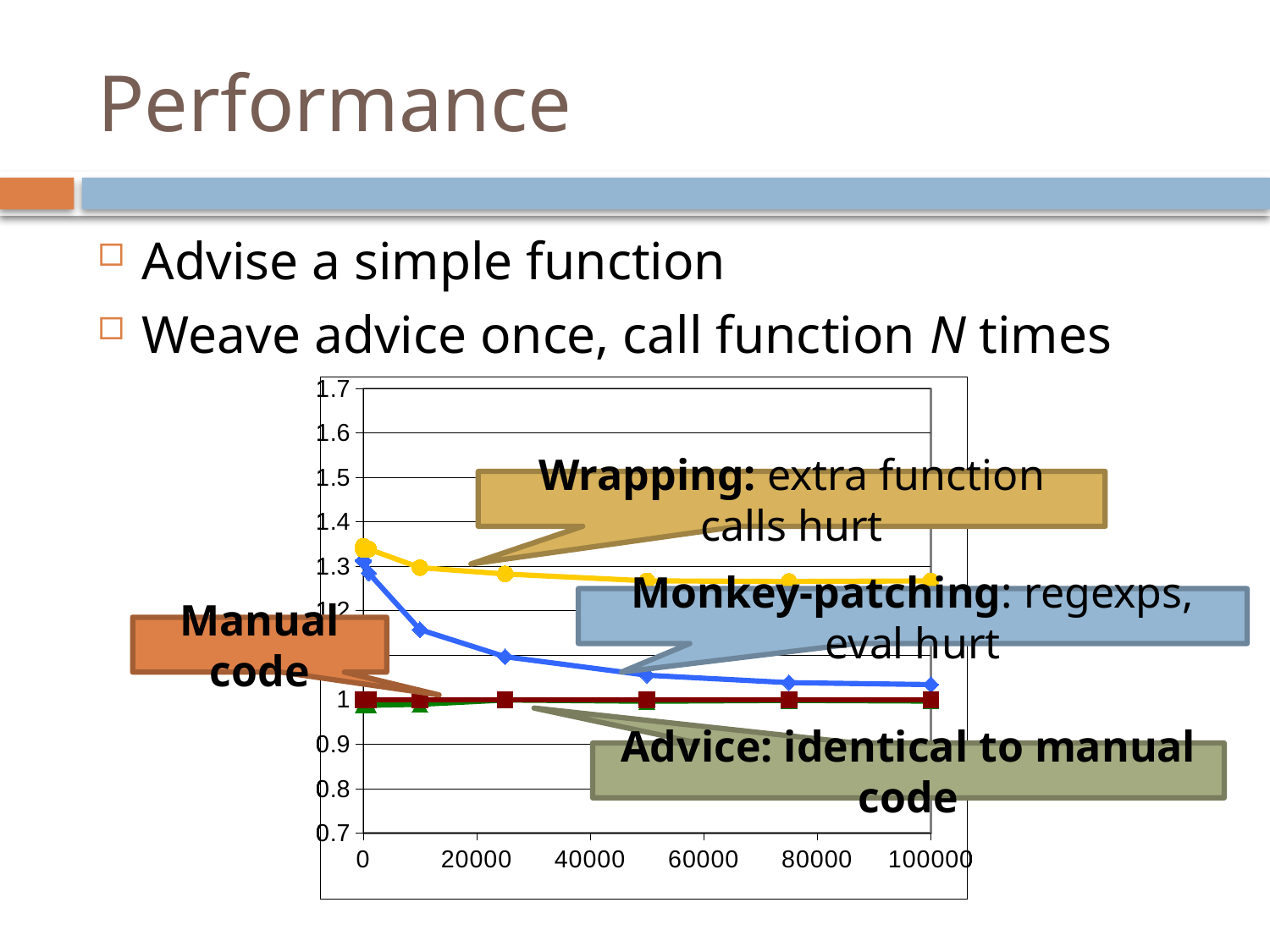
What is the highest tick value shown on the y axis? 1.7 Which series has the highest value at N = 100000? Wrapping Is the value for Monkey-patching at N = 100000 greater or less than 1.1? less Does the Wrapping line rise or fall as N increases along the x axis? fall Is the value for Monkey-patching at N = 0 greater or less than 1.2? greater At N = 100000, which is larger: the Wrapping value or the Monkey-patching value? Wrapping Is the value for Wrapping at N = 100000 greater or less than 1.2? greater How many lines (series) are plotted on the chart? 4 Does the Monkey-patching line rise or fall as N increases along the x axis? fall What kind of chart is shown on the slide? line chart